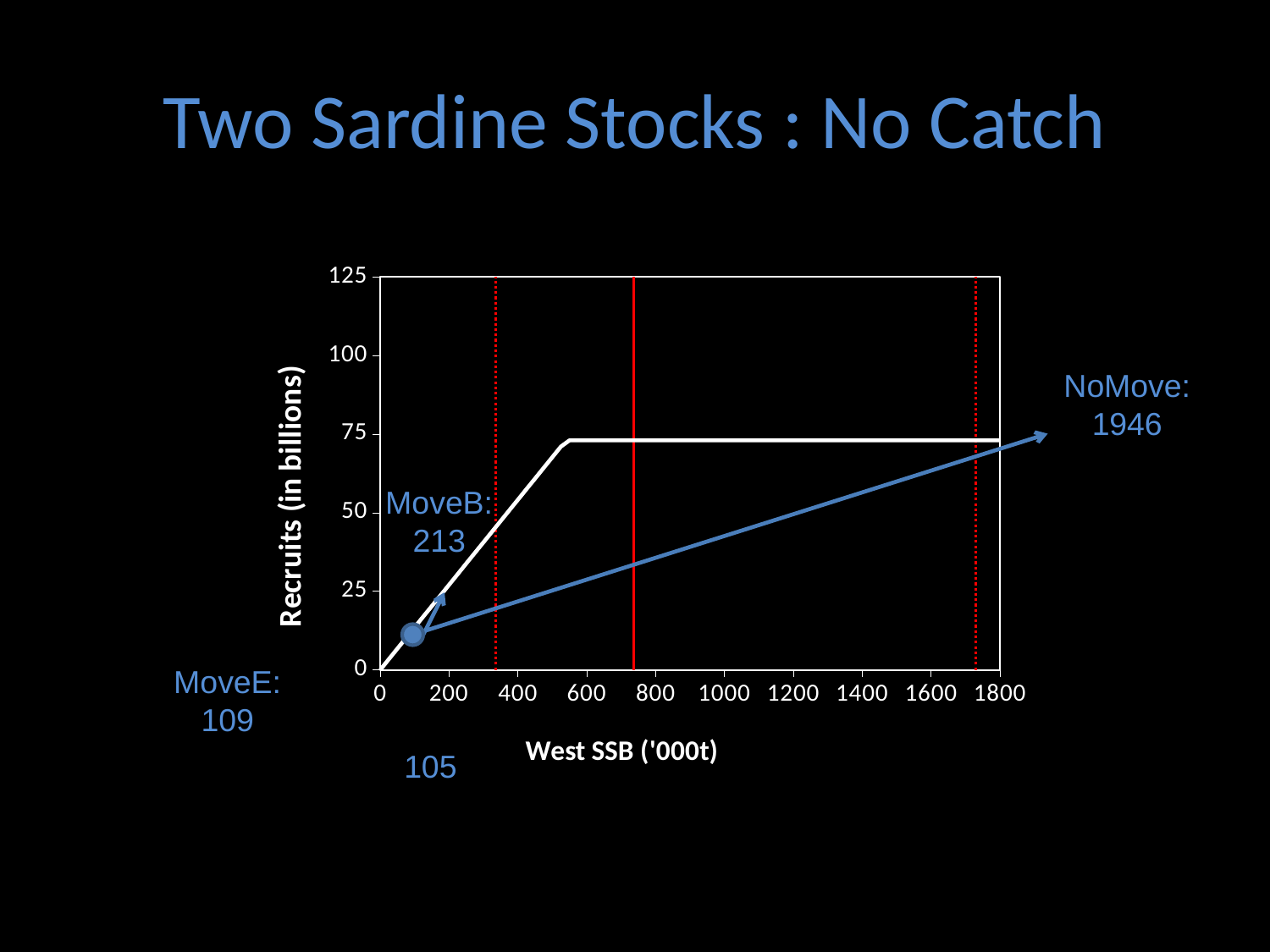
What value is annotated for the NoMove scenario? 1946 Which annotated scenario has the lowest value: MoveB, MoveE or NoMove? MoveE What is the label of the x axis? West SSB ('000t) How does the white recruitment line behave as West SSB increases from 0 to 1800? rises, then flattens What is the label of the y axis? Recruits (in billions) What value is annotated for the MoveE scenario? 109 What value is annotated for the MoveB scenario? 213 What kind of chart is shown on the slide? line chart What is the title of the chart on the slide? Two Sardine Stocks : No Catch Is the flat (plateau) level of the white line greater or less than 50 recruits? greater What is the difference between the NoMove value (1946) and the MoveB value (213)? 1733 Which annotated scenario has the highest value: MoveB, MoveE or NoMove? NoMove